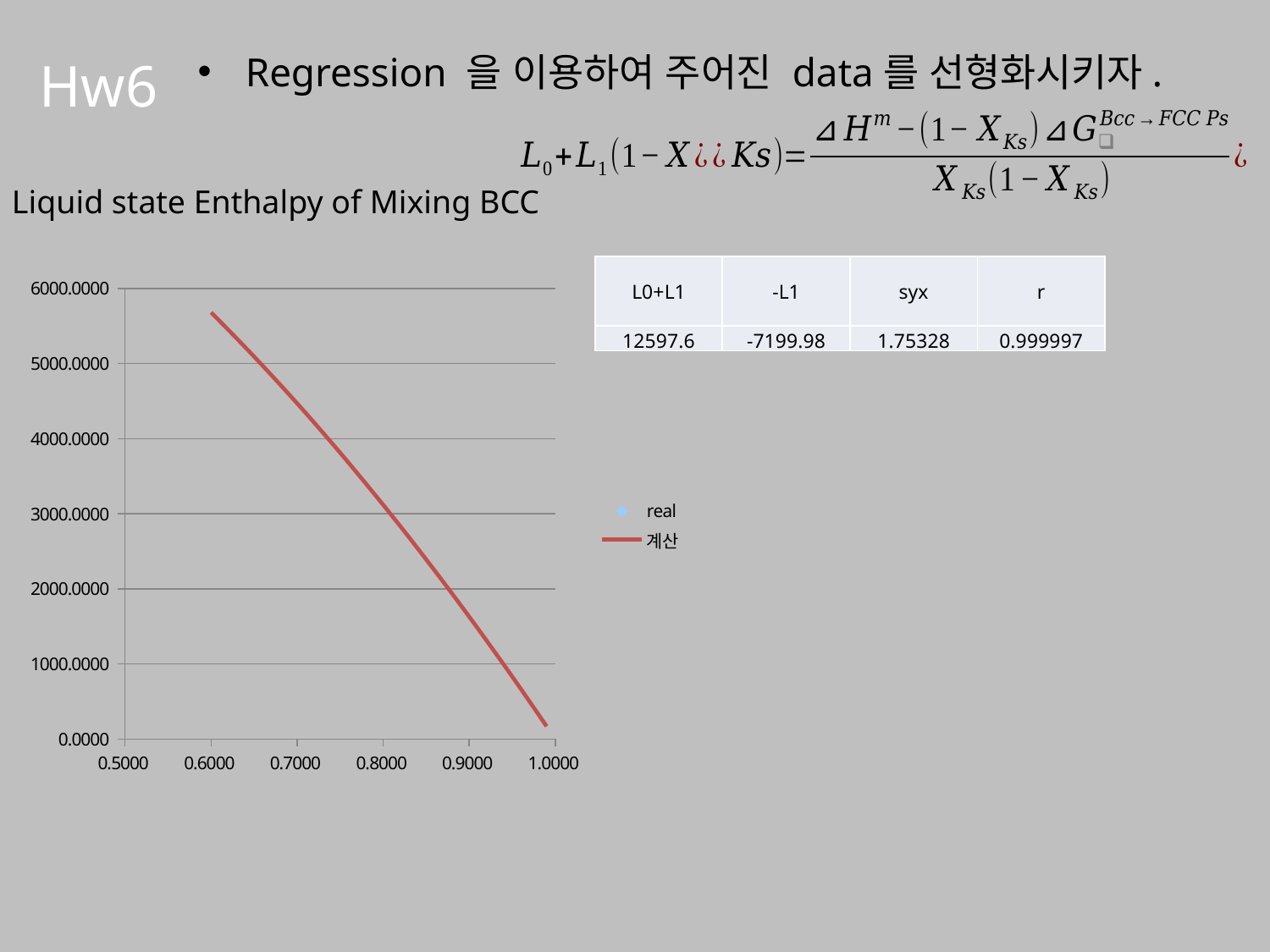
Is the value of the 계산 line higher at x = 0.6000 or at x = 0.9000? 0.6000 What kind of chart is shown on the slide? line chart Is the value of the 계산 line at x = 1.0000 greater or less than 1000? less Is the value of the 계산 line at x = 0.9000 greater or less than 2000? less What is the lowest tick value shown on the x-axis of the chart? 0.5000 Is the value of the 계산 line at x = 0.7000 greater or less than 4000? greater Do the plotted values rise or fall as the x-axis value increases from 0.6 to 1.0? fall What is the highest tick value shown on the y-axis of the chart? 6000.0000 What is the title of the chart on the slide? Liquid state Enthalpy of Mixing BCC What are the two entries in the chart legend? real and 계산 How many series does the chart legend list? 2